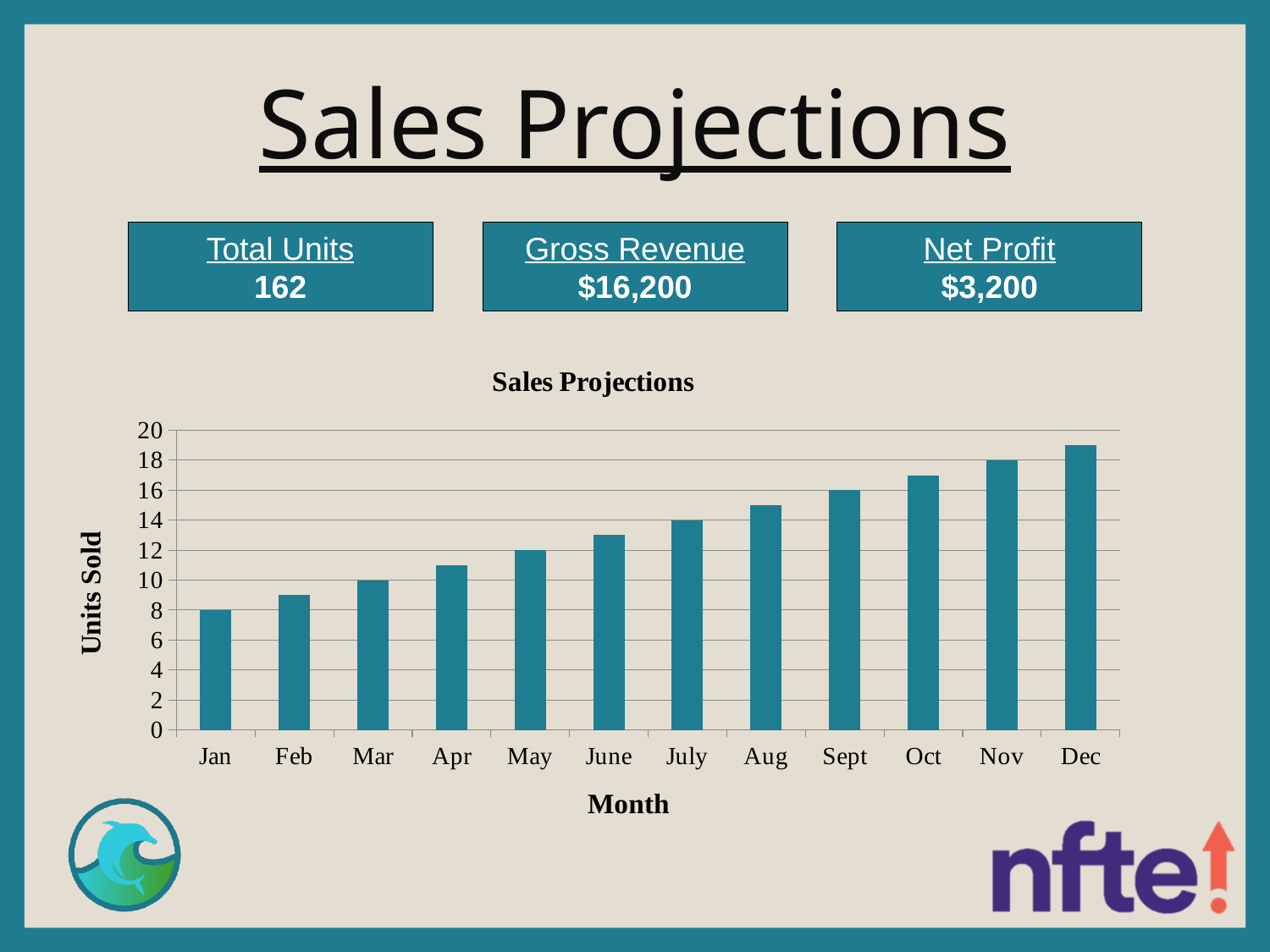
How many units are sold in Jan? 8 What is the difference in units sold between Nov and Jan? 10 Which month has more units sold, Aug or Apr? Aug How many months are plotted on the x axis of the Sales Projections chart? 12 What is the label on the vertical axis of the chart? Units Sold How many units are sold in Mar? 10 Which month has the lowest units sold? Jan Which month has the highest units sold? Dec How many units are sold in Sept? 16 Is the value for Dec greater or less than 18? greater What kind of chart is shown on the slide? bar chart Do the units sold rise or fall from Jan to Dec? rise